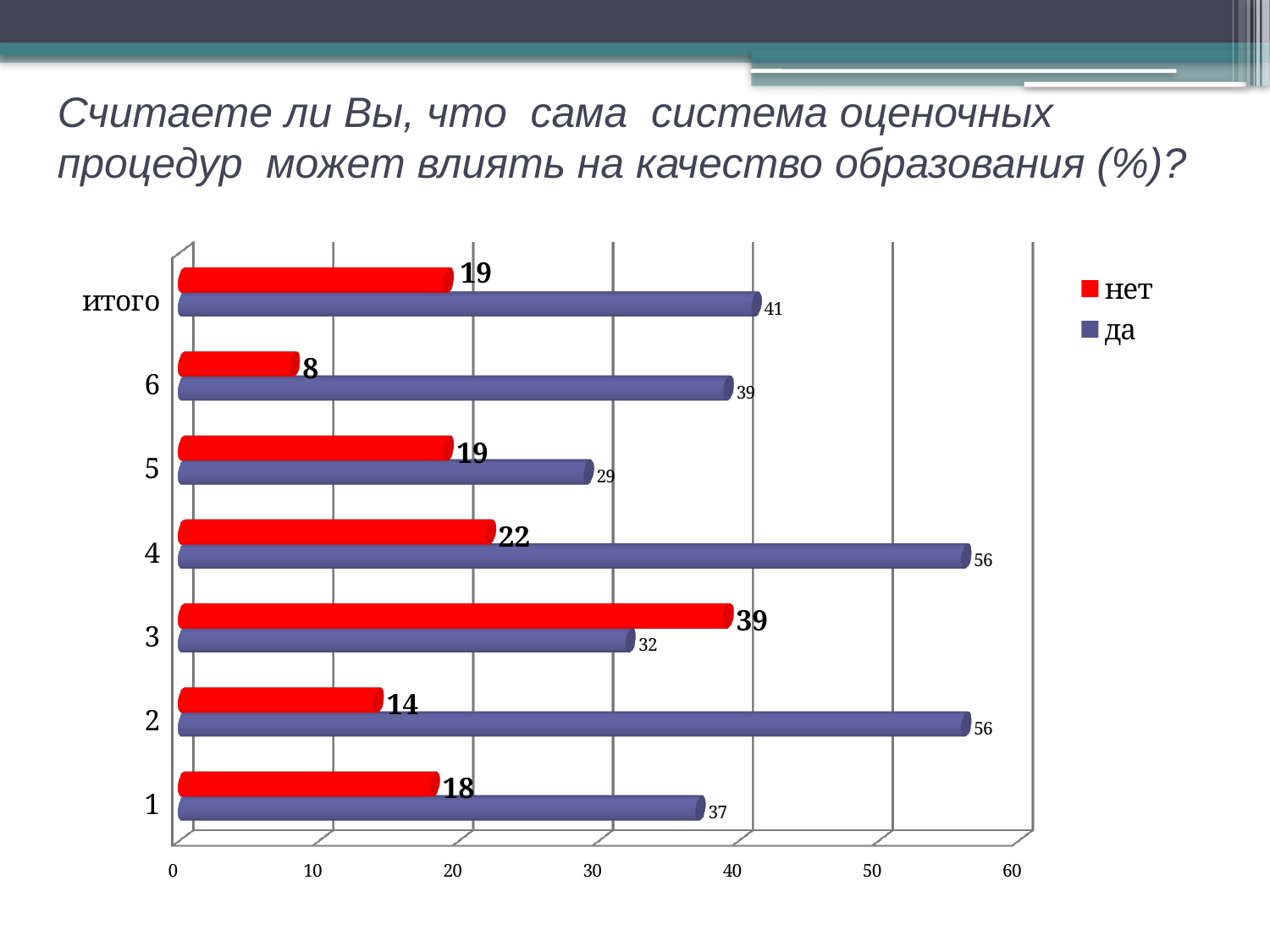
How many series does the legend list? 2 Which colour represents the "нет" series? red In category 3, which is larger, "да" or "нет"? нет How many categories are shown on the vertical axis? 7 What is the value for "да" in the "итого" category? 41 What is the difference between "да" and "нет" in category 2? 42 What kind of chart is shown on the slide? bar chart Which category has the highest value for "нет"? 3 What is the value for "да" in category 4? 56 What is the value for "нет" in category 3? 39 Which category has the lowest value for "да"? 5 What is the value for "нет" in category 6? 8